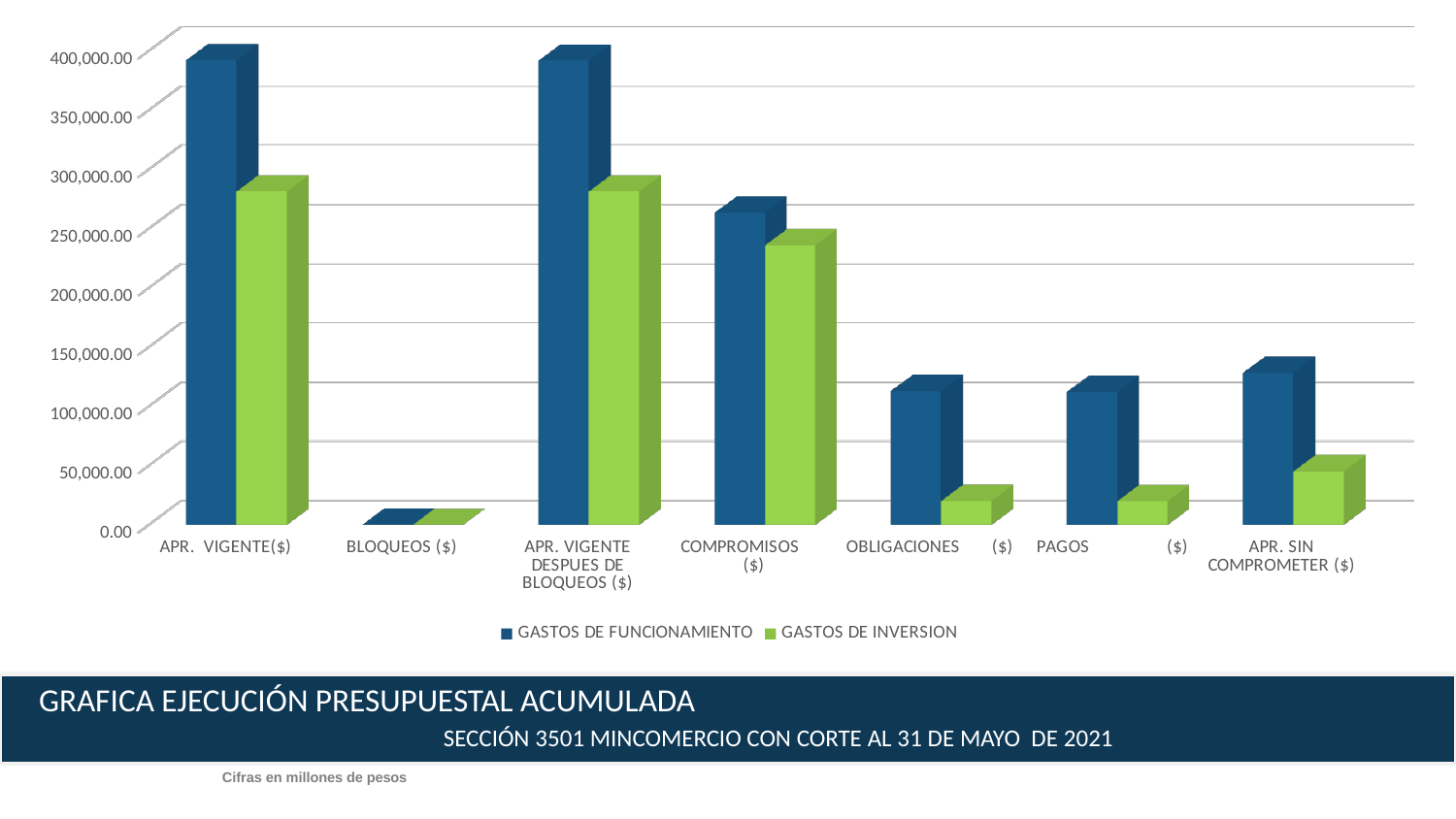
Is the GASTOS DE INVERSION value for PAGOS ($) greater or less than 50,000.00? less Is the GASTOS DE FUNCIONAMIENTO value for APR. VIGENTE($) greater or less than 350,000.00? greater Which category has the lowest value for GASTOS DE FUNCIONAMIENTO? BLOQUEOS ($) Which is larger: the GASTOS DE INVERSION value for APR. SIN COMPROMETER ($) or the GASTOS DE INVERSION value for OBLIGACIONES ($)? APR. SIN COMPROMETER ($) How many categories are shown on the x axis? 7 Is the GASTOS DE INVERSION value for COMPROMISOS ($) greater or less than 200,000.00? greater What kind of chart is shown on the slide? bar chart How many series does the legend list? 2 What unit note is printed below the chart? Cifras en millones de pesos For COMPROMISOS ($), which series has the larger value, GASTOS DE FUNCIONAMIENTO or GASTOS DE INVERSION? GASTOS DE FUNCIONAMIENTO Which series is shown in green in the legend? GASTOS DE INVERSION